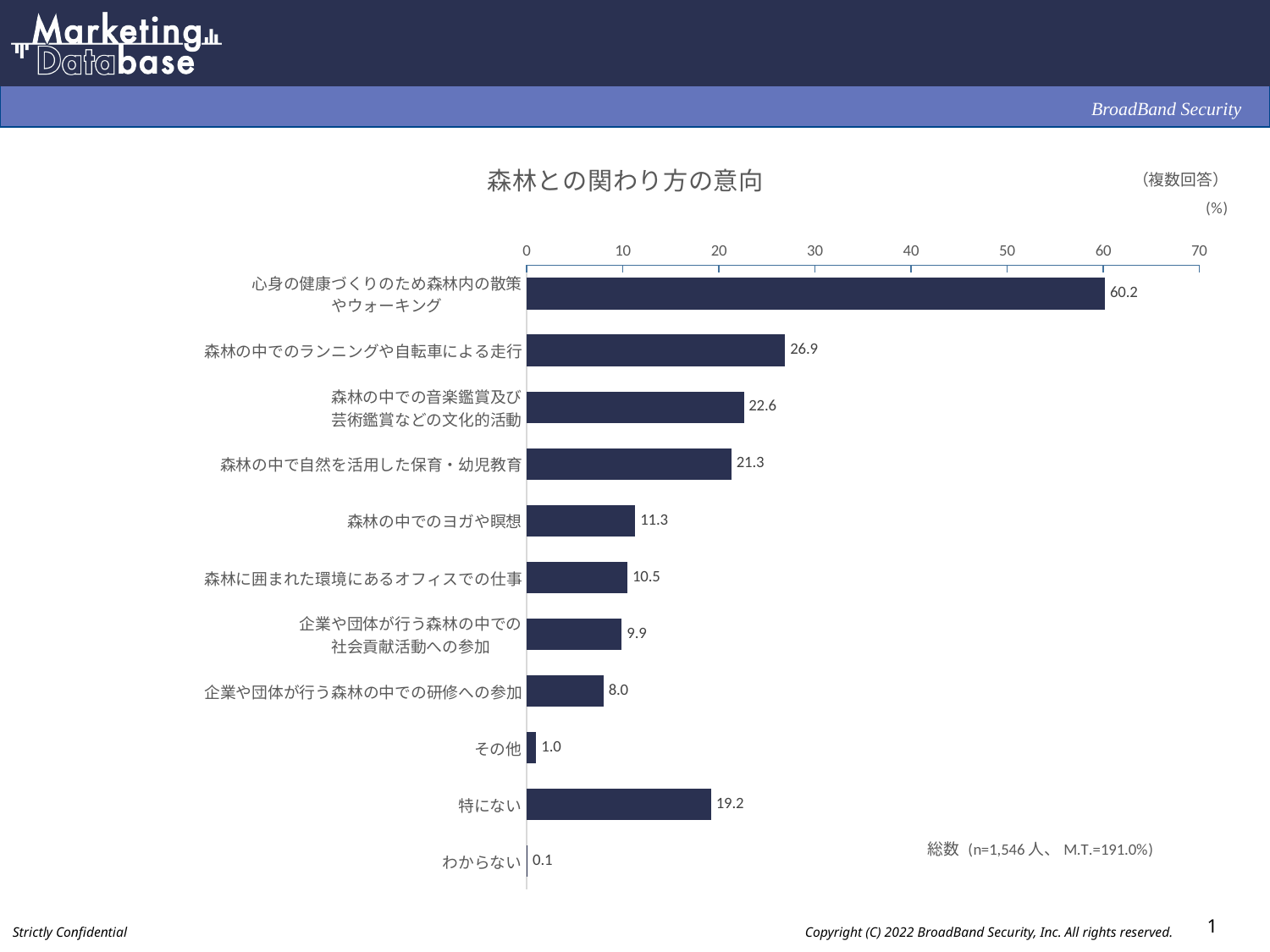
What is the value for 森林の中でのヨガや瞑想? 11.3 Is the value for 森林の中で自然を活用した保育・幼児教育 greater or less than 20? greater What is the title of the chart? 森林との関わり方の意向 Which category has the lowest value? わからない Which category has the highest value? 心身の健康づくりのため森林内の散策やウォーキング What is the difference between 森林の中でのランニングや自転車による走行 and 森林の中での音楽鑑賞及び芸術鑑賞などの文化的活動? 4.3 What kind of chart is shown on the slide? bar chart What is the sample size (n) shown on the chart? 1,546 Which is larger, 森林に囲まれた環境にあるオフィスでの仕事 or 企業や団体が行う森林の中での研修への参加? 森林に囲まれた環境にあるオフィスでの仕事 What is the value for 特にない? 19.2 How many categories are shown in the chart? 11 What is the value for 心身の健康づくりのため森林内の散策やウォーキング? 60.2